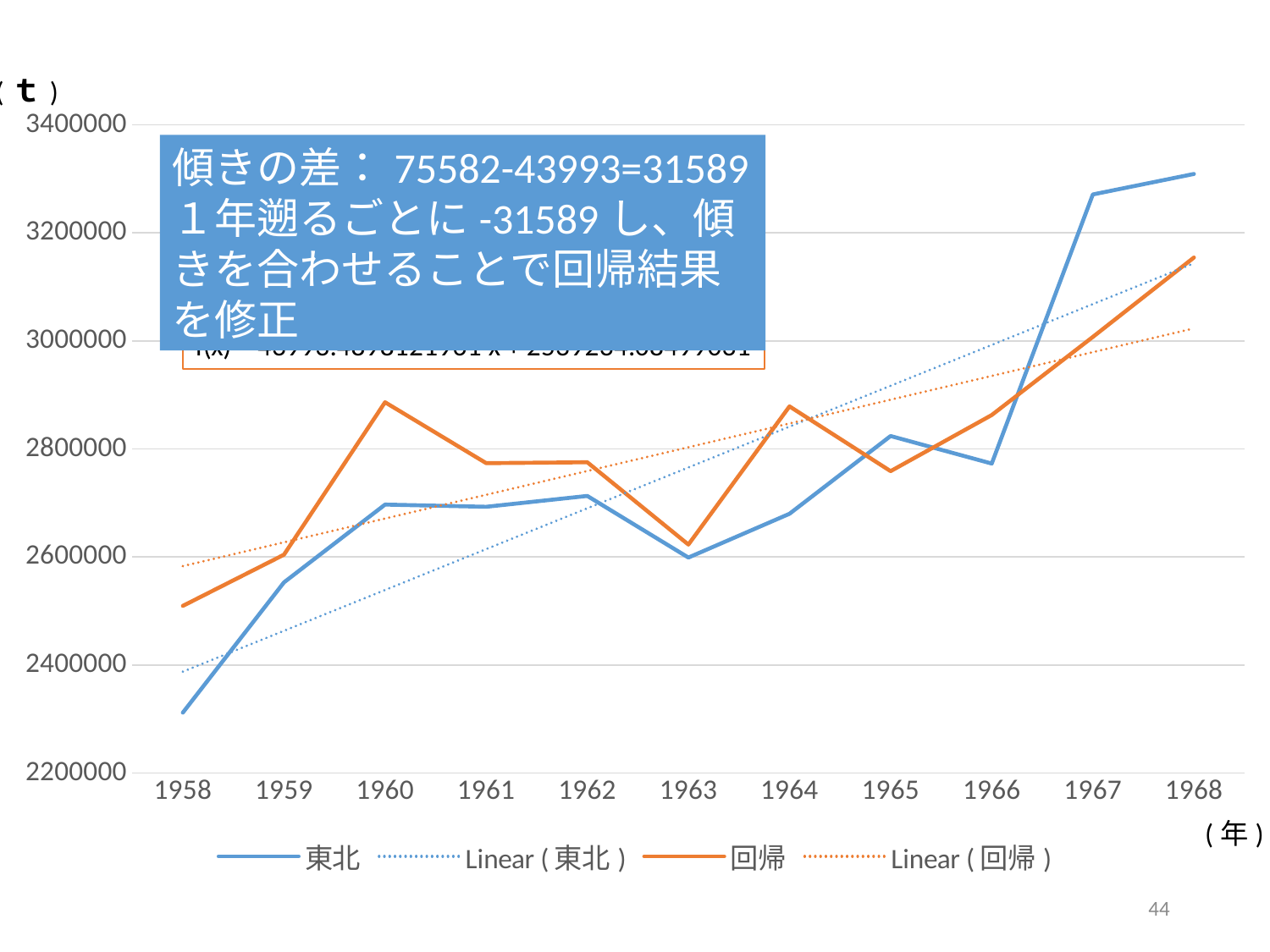
Overall, does the 東北 series rise or fall from 1958 to 1968? rise In 1960, which series has the larger value, 東北 or 回帰? 回帰 How many entries does the chart's legend list? 4 Is the value for 東北 in 1967 greater or less than 3200000? greater How many years are shown on the x axis of the chart? 11 In which year does the 回帰 series have its lowest value? 1958 In 1967, which series has the larger value, 東北 or 回帰? 東北 Is the value for 東北 in 1958 greater or less than 2400000? less In which year does the 東北 series reach its highest value? 1968 Is the value for 回帰 in 1960 greater or less than 2800000? greater What kind of chart is shown on the slide? line chart In which year does the 東北 series have its lowest value? 1958